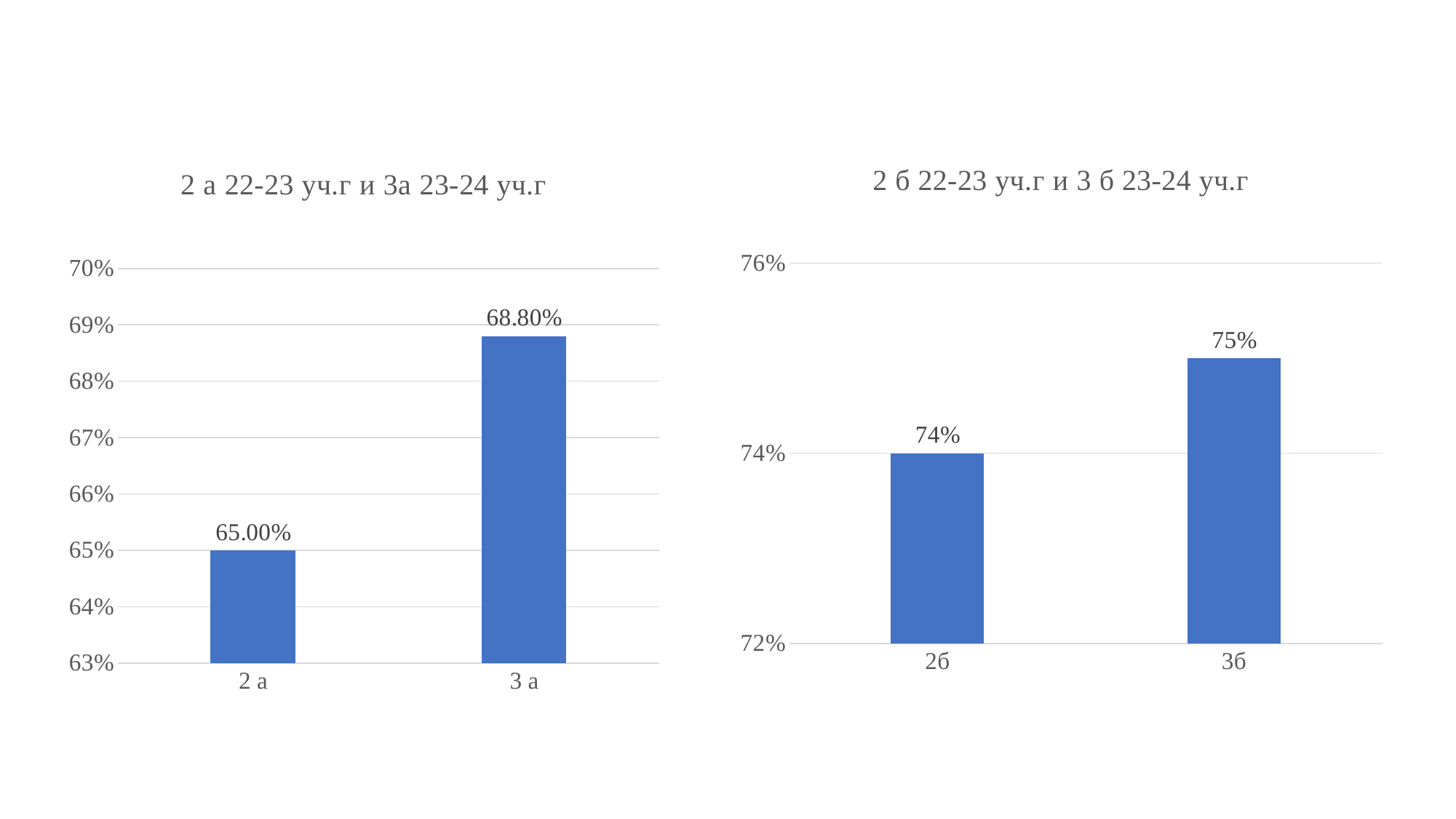
In the left chart titled "2 а 22-23 уч.г и 3а 23-24 уч.г", what is the value for 2 а? 65.00% In the right chart titled "2 б 22-23 уч.г и 3 б 23-24 уч.г", what is the value for 3б? 75% In the right chart titled "2 б 22-23 уч.г и 3 б 23-24 уч.г", what is the value for 2б? 74% How many bars are shown in the left chart? 2 In the right chart, which category has the lowest value? 2б In the right chart, what is the difference between the values for 3б and 2б? 1% In the right chart, which is larger: the value for 2б or the value for 3б? 3б In the left chart, what is the difference between the values for 3 а and 2 а? 3.80% In the left chart, which category has the highest value? 3 а What kind of chart is the right chart? Bar chart In the left chart, do the values rise or fall from 2 а to 3 а? Rise In the left chart titled "2 а 22-23 уч.г и 3а 23-24 уч.г", what is the value for 3 а? 68.80%